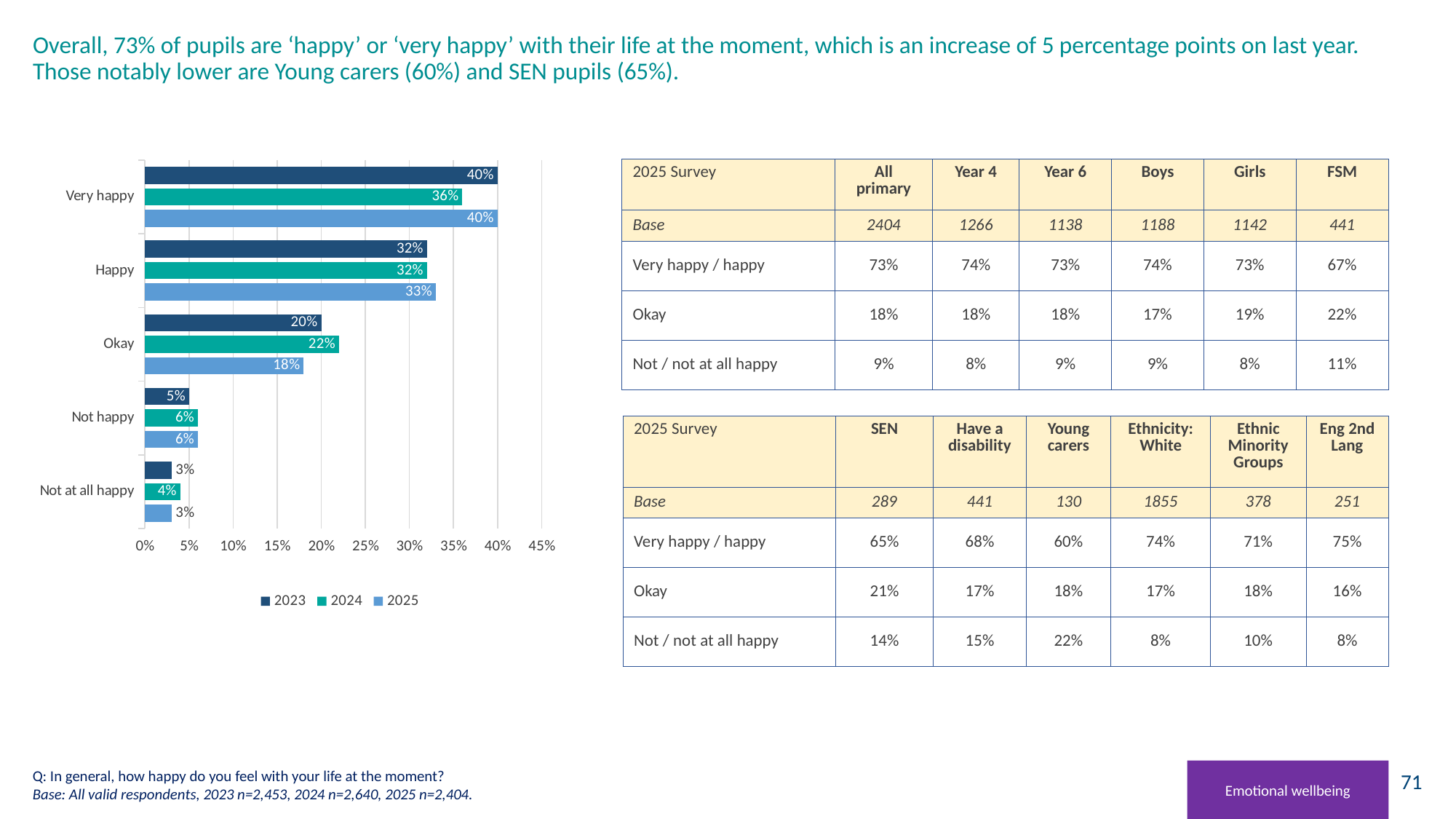
What is the 2025 value for 'Okay'? 18% How many response categories are shown on the chart? 5 How many series does the chart legend list? 3 What is the 2023 value for 'Not happy'? 5% What is the difference between the 2025 and 2024 values for 'Very happy'? 4 percentage points Which is larger for 'Okay': the 2024 value or the 2025 value? 2024 Which category has the highest value in the 2025 series? Very happy What type of chart is shown on the slide? Bar chart What percentage of pupils said they were 'Very happy' in 2024? 36% Which years are listed in the chart legend? 2023, 2024, 2025 What is the difference between the 2023 and 2025 values for 'Happy'? 1 percentage point Which category has the lowest value in the 2024 series? Not at all happy